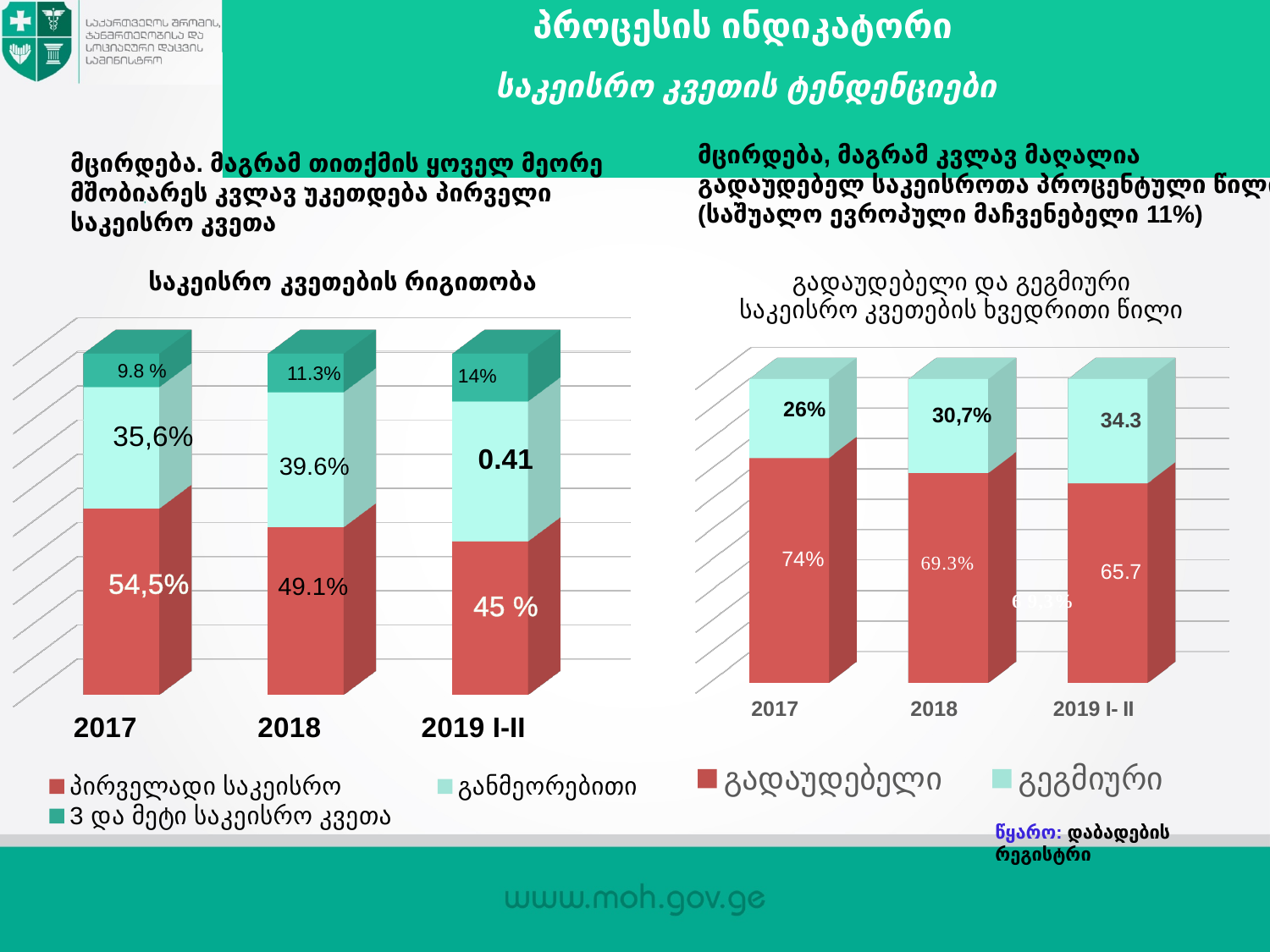
In the right chart (გადაუდებელი და გეგმიური საკეისრო კვეთების ხვედრითი წილი), which year has the highest value for გეგმიური? 2019 I-II In the right chart (გადაუდებელი და გეგმიური საკეისრო კვეთების ხვედრითი წილი), which is larger for 2017: გადაუდებელი or გეგმიური? გადაუდებელი In the left chart (საკეისრო კვეთების რიგითობა), what is the value of განმეორებითი for 2018? 39.6% In the left chart (საკეისრო კვეთების რიგითობა), does the value of პირველადი საკეისრო rise or fall from 2017 to 2019 I-II? fall In the right chart (გადაუდებელი და გეგმიური საკეისრო კვეთების ხვედრითი წილი), what is the value of გადაუდებელი for 2017? 74% In the right chart (გადაუდებელი და გეგმიური საკეისრო კვეთების ხვედრითი წილი), what is the value of გეგმიური for 2018? 30,7% In the left chart (საკეისრო კვეთების რიგითობა), what is the value of 3 და მეტი საკეისრო კვეთა for 2019 I-II? 14% In the right chart (გადაუდებელი და გეგმიური საკეისრო კვეთების ხვედრითი წილი), what is the value of გადაუდებელი for 2019 I-II? 65.7 What kind of chart is the right chart (გადაუდებელი და გეგმიური საკეისრო კვეთების ხვედრითი წილი)? stacked bar chart In the left chart (საკეისრო კვეთების რიგითობა), how many series does the legend list? 3 In the left chart (საკეისრო კვეთების რიგითობა), what is the value of პირველადი საკეისრო for 2017? 54,5% In the left chart (საკეისრო კვეთების რიგითობა), which year has the lowest value for პირველადი საკეისრო? 2019 I-II